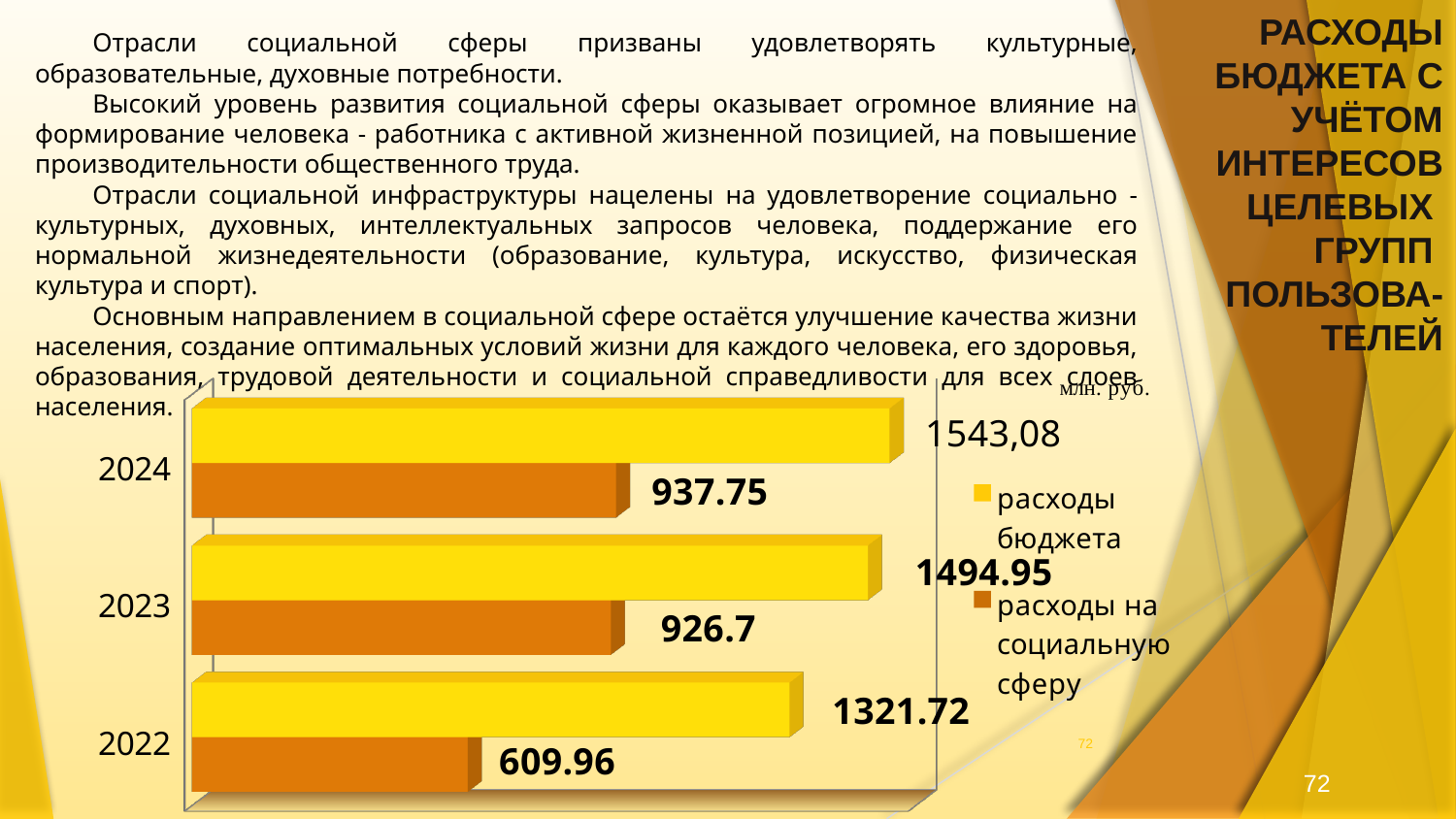
Which is larger: расходы бюджета in 2022 or расходы на социальную сферу in 2024? расходы бюджета in 2022 How many years are shown on the chart? 3 Which year has the lowest value for расходы бюджета? 2022 What is the value of расходы на социальную сферу for 2022? 609.96 Which year has the highest value for расходы на социальную сферу? 2024 What is the value of расходы бюджета for 2023? 1494.95 What is the difference between расходы бюджета and расходы на социальную сферу in 2023? 568.25 What is the value of расходы на социальную сферу for 2024? 937.75 How many series does the legend list? 2 What is the value of расходы бюджета for 2024? 1543,08 What is the difference between расходы на социальную сферу in 2024 and in 2022? 327.79 What type of chart is shown on the slide? bar chart